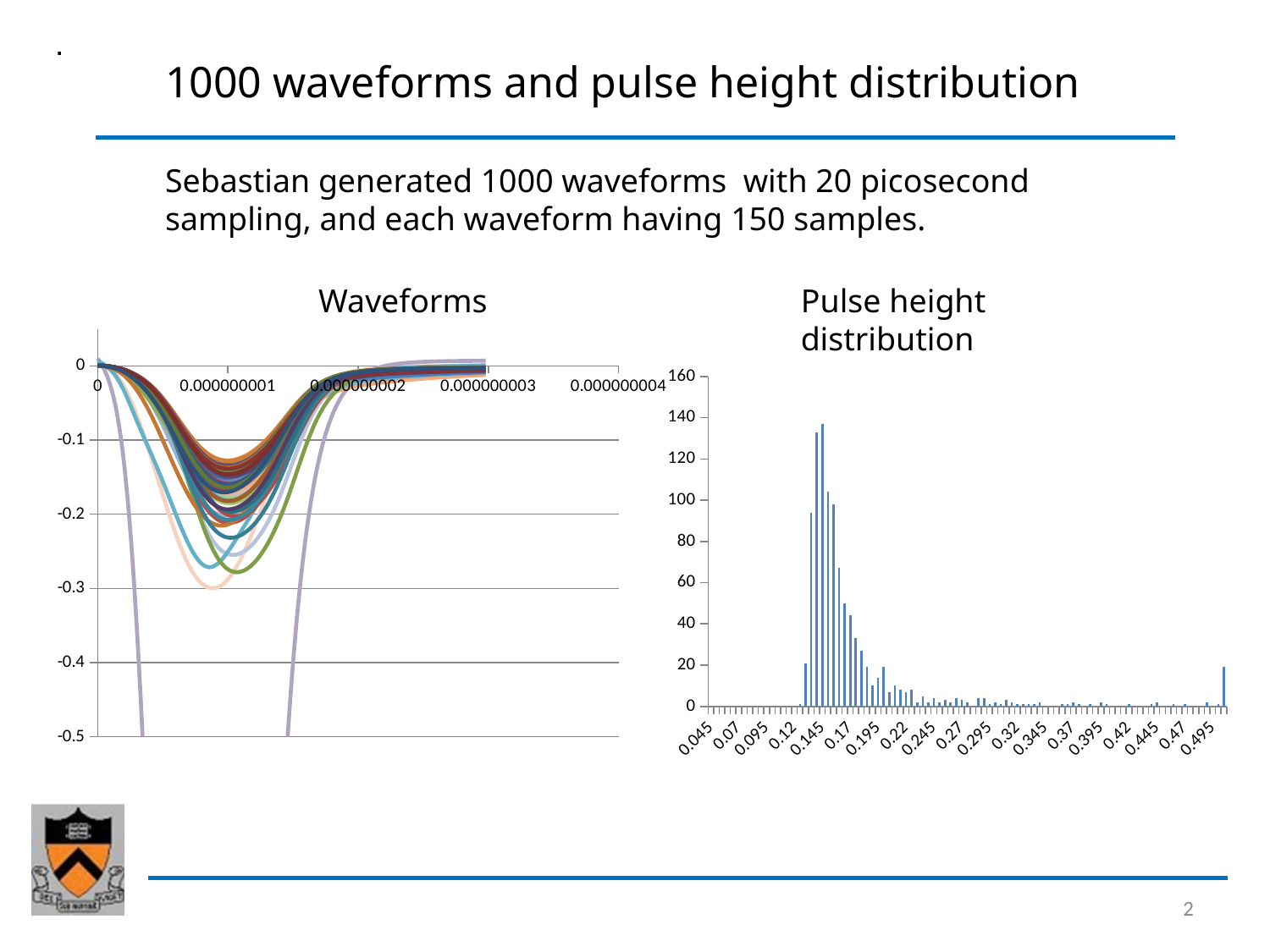
What kind of chart is the Waveforms chart on the left? line chart What kind of chart is the Pulse height distribution chart on the right? bar chart What is the lowest value shown on the y axis of the Waveforms chart? -0.5 In the Pulse height distribution chart, do the bar heights rise or fall as the x-axis values increase beyond the peak near 0.145? fall In the Pulse height distribution chart, is the tallest bar greater or less than 120? greater What is the highest value shown on the y axis of the Pulse height distribution chart? 160 In the Pulse height distribution chart, is the tallest bar located near 0.145 or near 0.345 on the x axis? near 0.145 In the Waveforms chart, is the lowest point of the deepest fully visible curve greater or less than -0.2? less In the Waveforms chart, do the curves first fall or first rise as the x-axis value increases from 0? fall In the Pulse height distribution chart, is the bar at 0.495 greater or less than 40? less